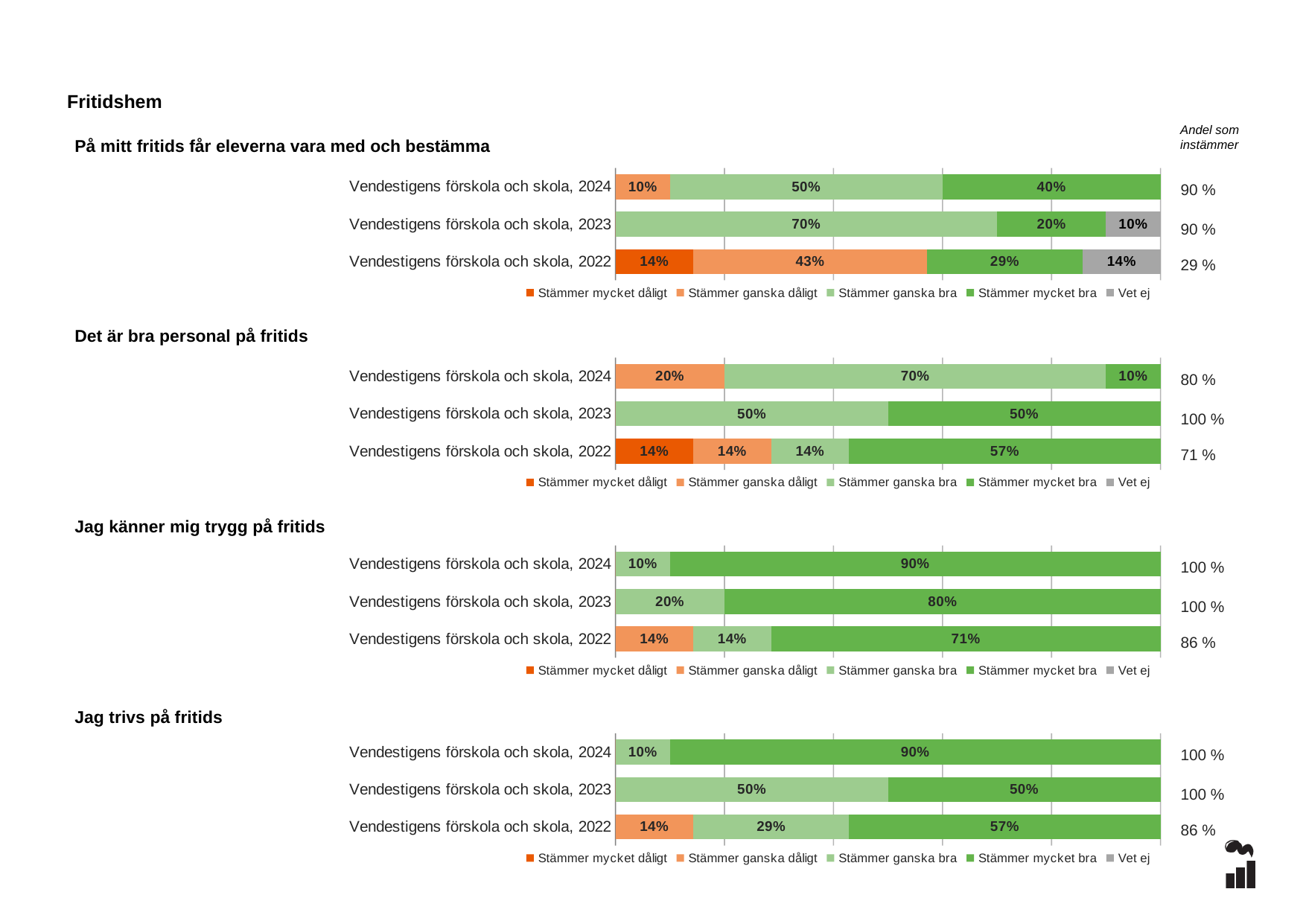
In the chart 'På mitt fritids får eleverna vara med och bestämma', what is the 'Vet ej' value for Vendestigens förskola och skola, 2023? 10% How many series does the legend list in the chart 'Jag trivs på fritids'? 5 In the chart 'Jag känner mig trygg på fritids', what is the 'Stämmer mycket bra' value for Vendestigens förskola och skola, 2024? 90% In the chart 'Det är bra personal på fritids', which year has the highest 'Andel som instämmer'? 2023 In the chart 'På mitt fritids får eleverna vara med och bestämma', what is the 'Stämmer ganska bra' value for Vendestigens förskola och skola, 2024? 50% In the chart 'Jag trivs på fritids', how many bars (years) are shown? 3 In the chart 'På mitt fritids får eleverna vara med och bestämma', what is the 'Andel som instämmer' value for Vendestigens förskola och skola, 2022? 29 % In the chart 'Jag känner mig trygg på fritids', which is larger: the 'Stämmer mycket bra' value for 2023 or for 2022? 2023 In the chart 'Det är bra personal på fritids', what is the 'Stämmer mycket bra' value for Vendestigens förskola och skola, 2022? 57% In the chart 'Det är bra personal på fritids', what is the difference between the 'Stämmer ganska bra' value for 2024 and the 'Stämmer ganska bra' value for 2023? 20% In the chart 'Jag trivs på fritids', what is the 'Stämmer ganska bra' value for Vendestigens förskola och skola, 2022? 29% What type of chart is 'Jag känner mig trygg på fritids'? Stacked bar chart